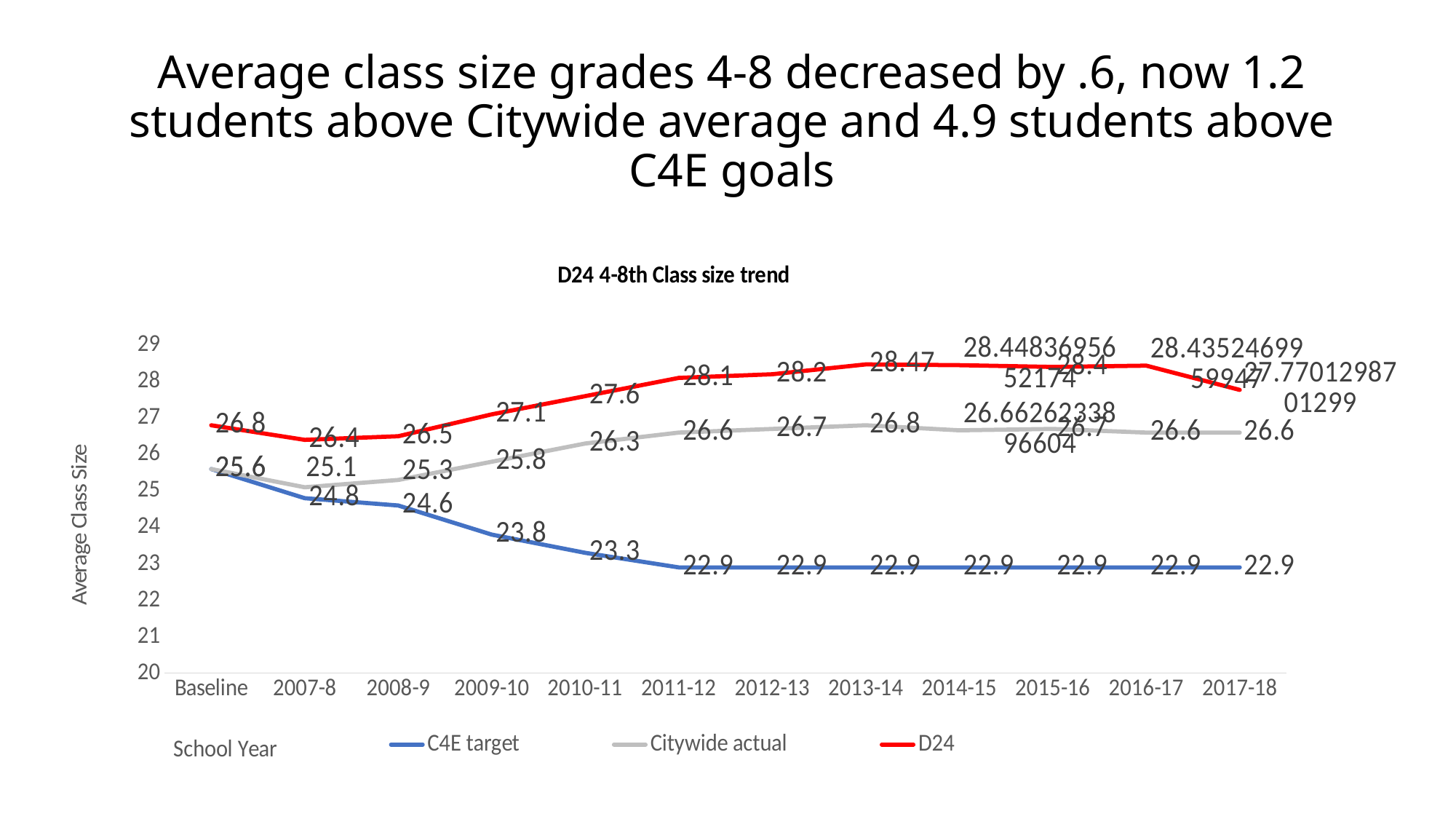
Is the C4E target value for 2017-18 greater or less than 23? less Does the C4E target series rise or fall from Baseline to 2011-12? fall In which school year is the Citywide actual value lowest? 2007-8 In which school year is the D24 value lowest? 2007-8 What is the C4E target value for 2009-10? 23.8 What is the difference between the D24 value and the Citywide actual value in 2011-12? 1.5 What kind of chart is shown on the slide? line chart What is the D24 value for 2013-14? 28.47 Which series has the larger value in 2012-13, D24 or Citywide actual? D24 How many series does the legend list? 3 How many school years are shown on the x axis? 12 What is the Citywide actual value for 2010-11? 26.3